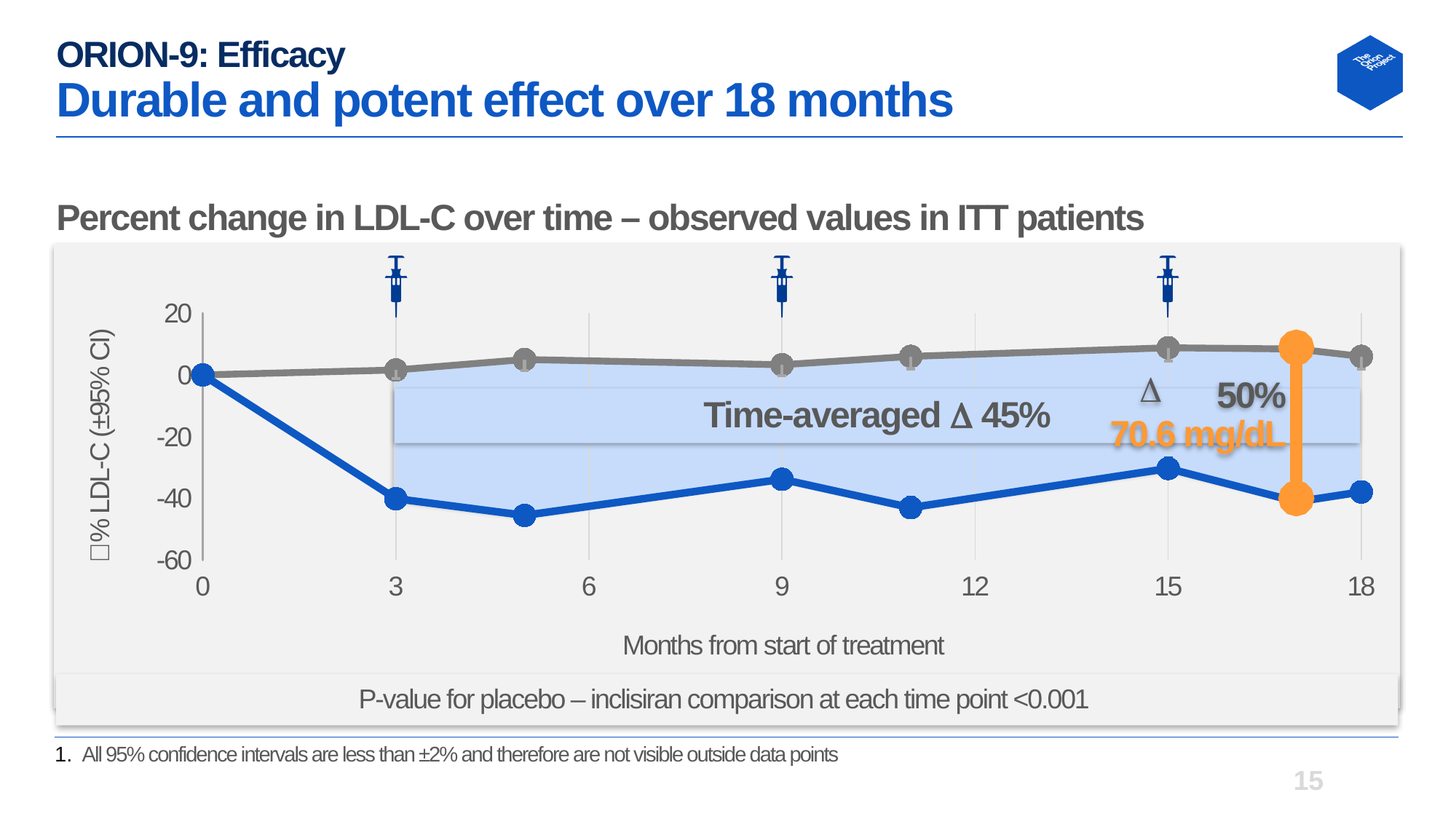
Is the value of the blue line at 3 months greater or less than -20? less How many lines are plotted on the chart? 2 Does the blue line rise or fall between 0 and 3 months? fall What is the title of the chart? Percent change in LDL-C over time – observed values in ITT patients What kind of chart is shown on the slide? line chart Is the value of the grey line at 15 months greater or less than 0? greater What is the label of the x axis? Months from start of treatment What time-averaged change is annotated on the chart? 45% What absolute LDL-C difference in mg/dL is annotated next to the orange bar at the right of the chart? 70.6 mg/dL At 18 months, which line has the higher value, the grey line or the blue line? grey line At which month does the blue line reach its highest value? 0 How many month values are labelled on the x axis? 7